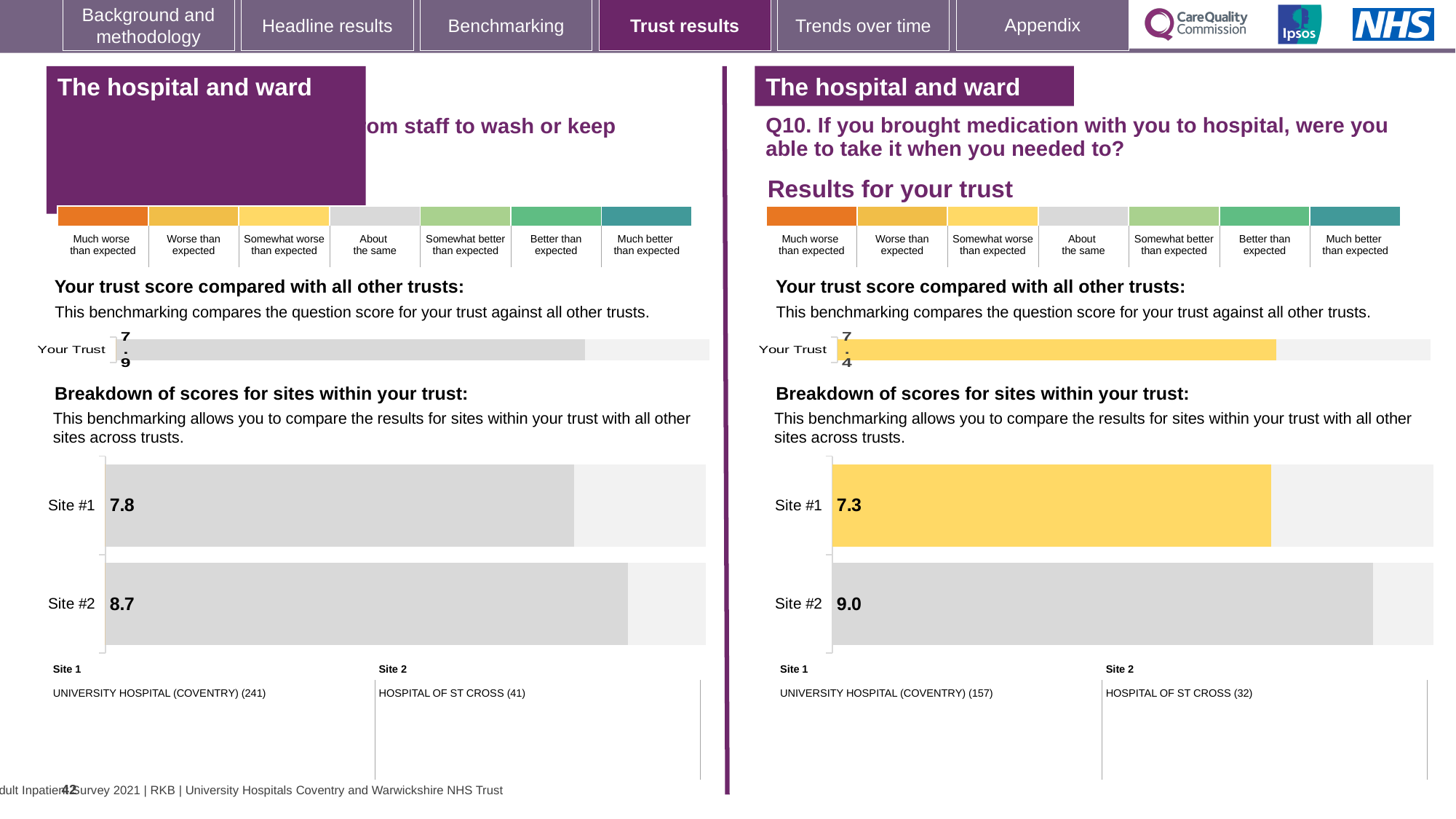
On the left-hand 'Your trust score compared with all other trusts' chart, what is the score for Your Trust? 7.9 On the right-hand (Q10) site breakdown chart, what is the difference between the Site #2 and Site #1 scores? 1.7 On the right-hand (Q10) 'Breakdown of scores for sites within your trust' chart, what is the score for Site #2? 9.0 How many sites are shown on the right-hand (Q10) site breakdown chart? 2 What kind of chart is used for the site breakdown on the right-hand (Q10) side of the slide? Bar chart On the right-hand (Q10) site breakdown chart, which site has the higher score? Site #2 On the left-hand 'Breakdown of scores for sites within your trust' chart, what is the score for Site #2? 8.7 On the right-hand (Q10) 'Breakdown of scores for sites within your trust' chart, what is the score for Site #1? 7.3 On the right-hand (Q10) 'Your trust score compared with all other trusts' chart, what is the score for Your Trust? 7.4 On the left-hand site breakdown chart, what is the difference between the Site #2 and Site #1 scores? 0.9 On the left-hand 'Breakdown of scores for sites within your trust' chart, what is the score for Site #1? 7.8 On the left-hand site breakdown chart, which site has the lower score? Site #1